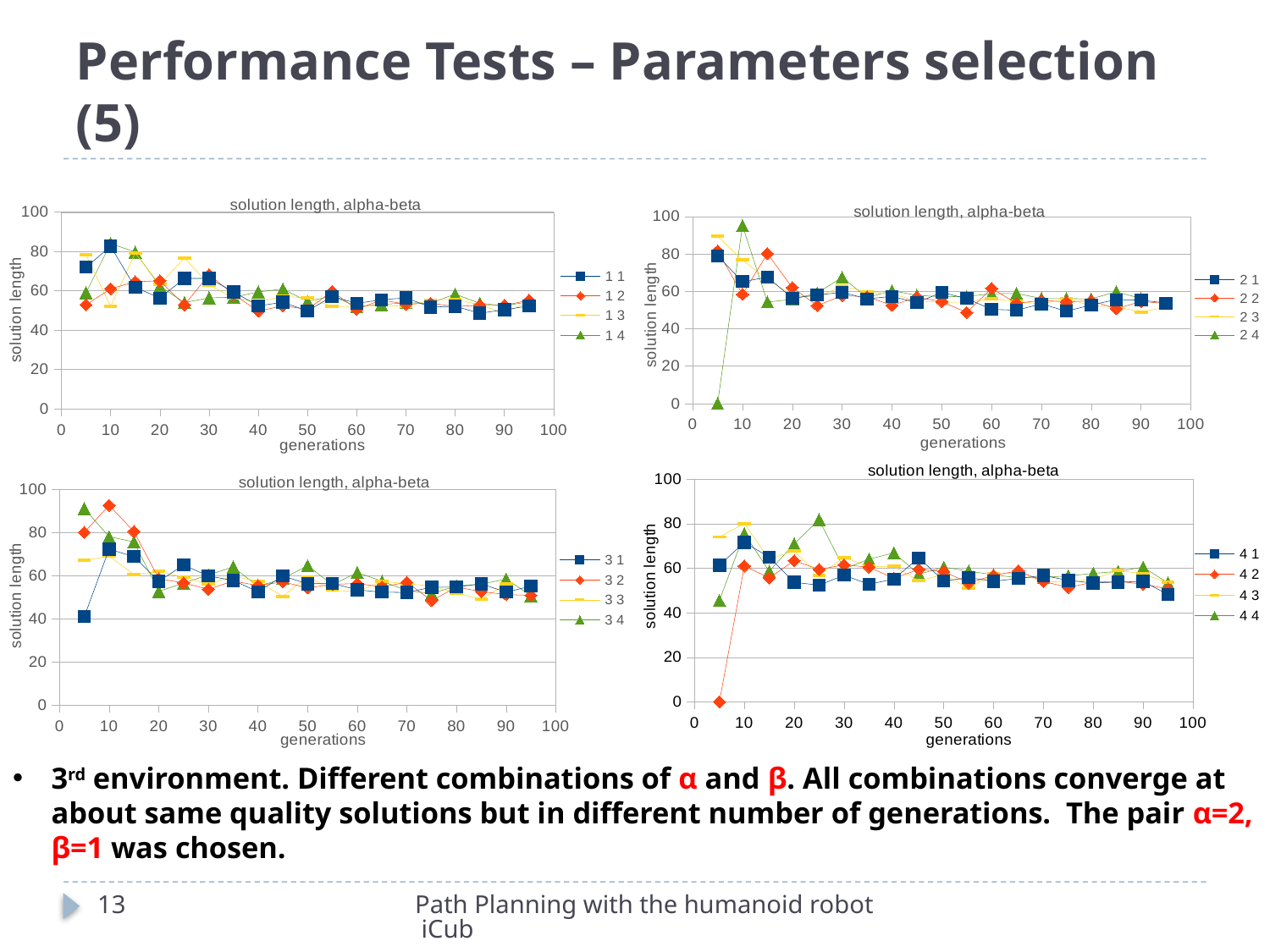
How many series does the legend of the top-left chart list? 4 In the top-left chart, is the value of series 1 1 at generation 5 greater or less than 60? greater What is the label of the y axis on the top-left chart? solution length In the bottom-left chart, is the value of series 3 2 at generation 10 greater or less than 80? greater What kind of chart is the top-left chart on the slide? line chart What is the title of the bottom-right chart? solution length, alpha-beta In the bottom-right chart, is the value of series 4 4 at generation 5 greater or less than 60? less In the bottom-right chart, what is the value of series 4 2 at generation 5? 0 In the bottom-left chart, do the values of series 3 2 generally rise or fall as generations increase? fall In the top-right chart, what is the value of series 2 4 at generation 5? 0